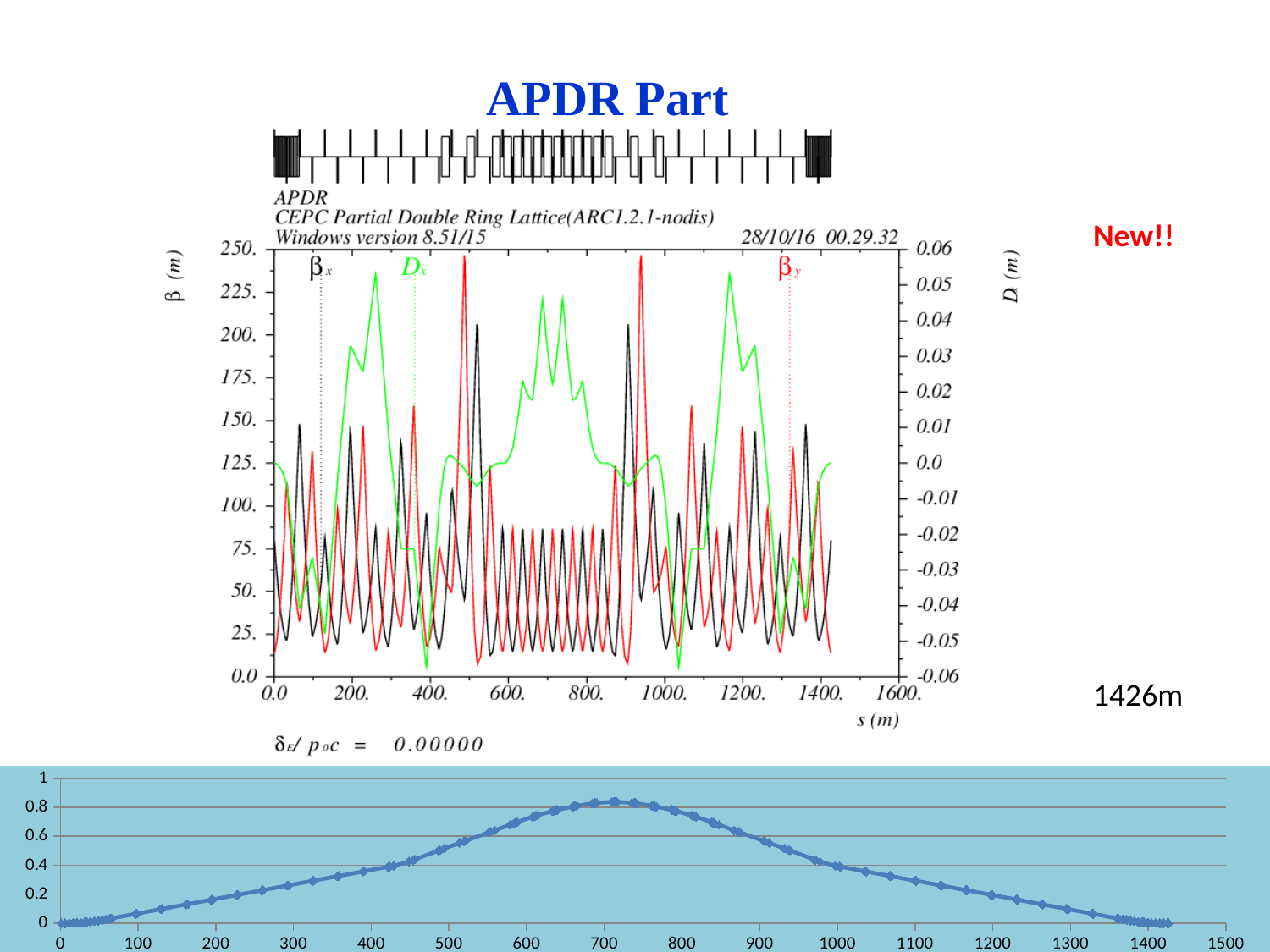
In the bottom chart, is the value at x=1300 greater or less than 0.2? less In the top chart (CEPC Partial Double Ring Lattice), is the highest peak of the green Dx curve greater or less than 0.04 m? greater In the top chart (CEPC Partial Double Ring Lattice), is the highest peak of the red βy curve greater or less than 200 m? greater In the top chart (CEPC Partial Double Ring Lattice), how many curves are plotted? 3 In the bottom chart, which is larger: the value at x=700 or the value at x=1000? the value at x=700 In the top chart (CEPC Partial Double Ring Lattice), which curve is drawn in green? Dx In the bottom chart, does the plotted value rise or fall as x goes from 0 to 700? rise In the bottom chart, does the plotted value rise or fall as x goes from 800 to 1400? fall What kind of chart is the bottom chart on the slide? line chart In the bottom chart, what is the highest value shown on the y axis? 1